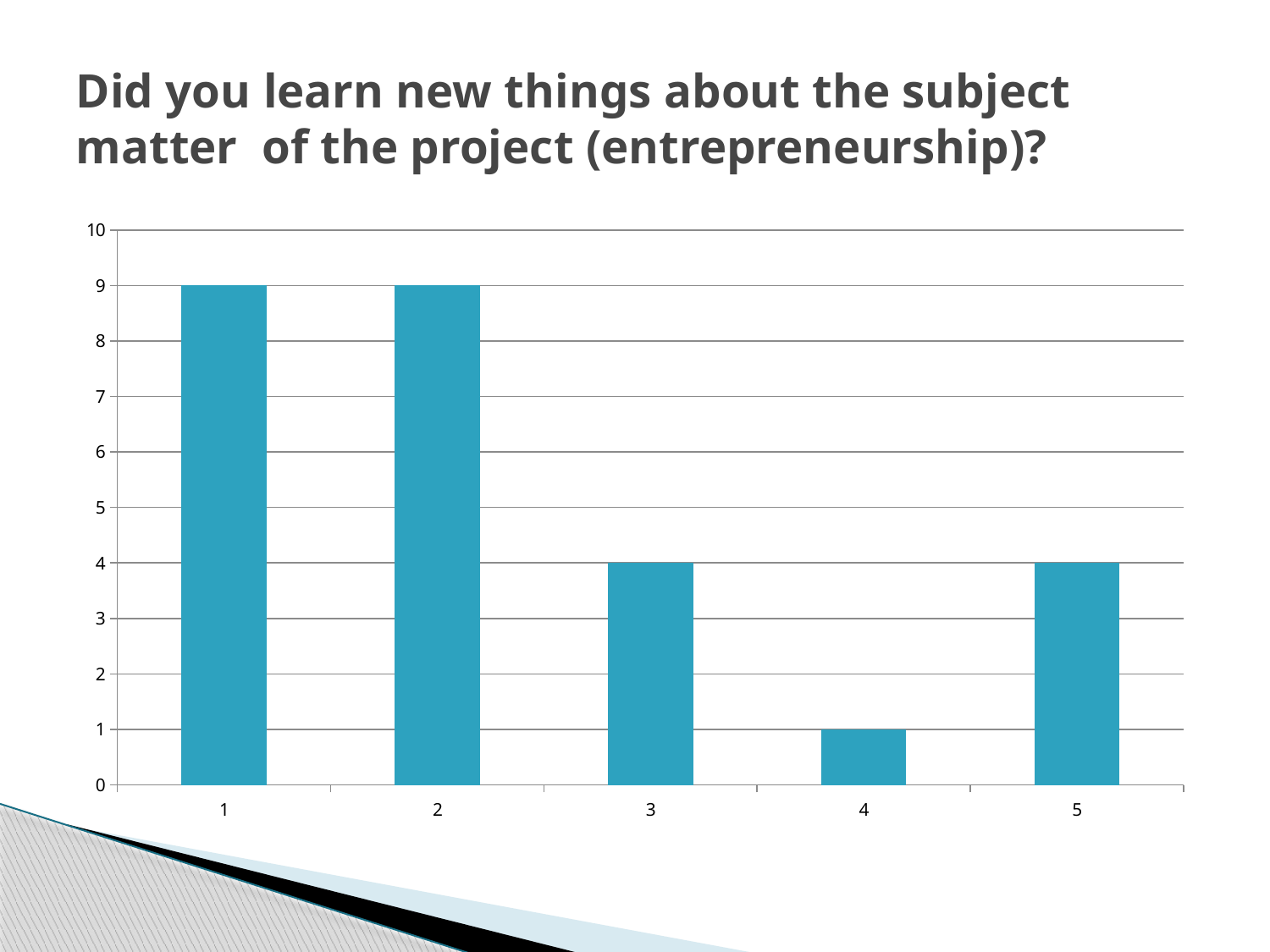
What is the difference between the values for category 2 and category 4? 8 How many categories are shown on the x axis? 5 What is the value for category 5? 4 What is the value for category 4? 1 Is the value for category 4 greater or less than 5? less What is the value for category 1? 9 Which category has the lowest value? 4 What is the highest value shown on the y axis? 10 What is the difference between the values for category 1 and category 3? 5 What is the value for category 3? 4 What kind of chart is shown on the slide? bar chart Which is larger, the value for category 2 or the value for category 5? category 2